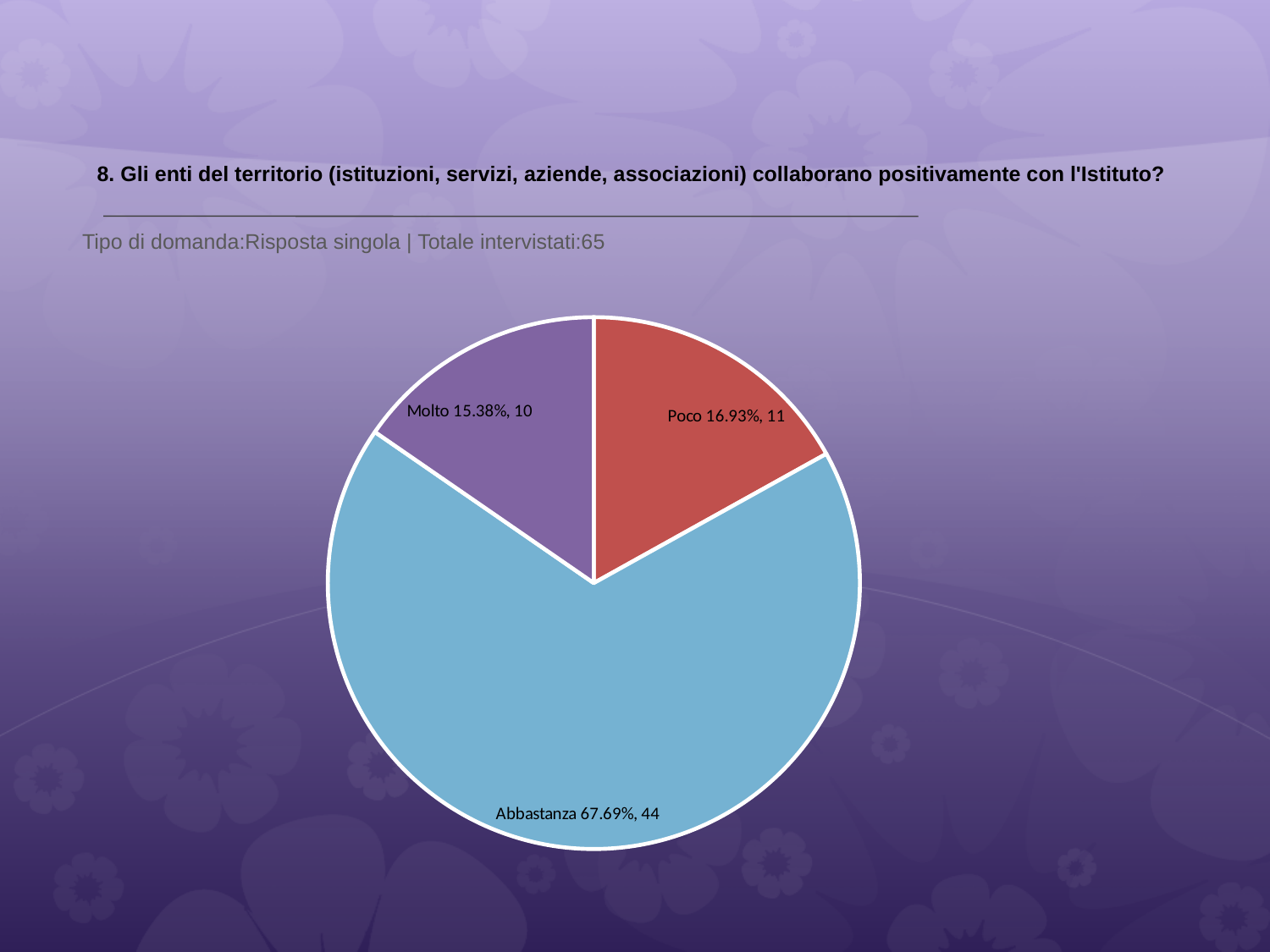
Which response has the largest slice of the pie? Abbastanza How many respondents answered Poco? 11 What percentage share does the Molto slice have? 15.38% Which response has the smallest slice of the pie? Molto What is the total number of respondents across all three slices? 65 How many slices does the pie chart have? 3 What is the difference in respondent count between Abbastanza and Poco? 33 What colour is the Abbastanza slice? light blue How many respondents answered Molto? 10 What kind of chart is shown on the slide? pie chart What is the total number of interviewees stated on the slide? 65 What percentage share does the Abbastanza slice have? 67.69%